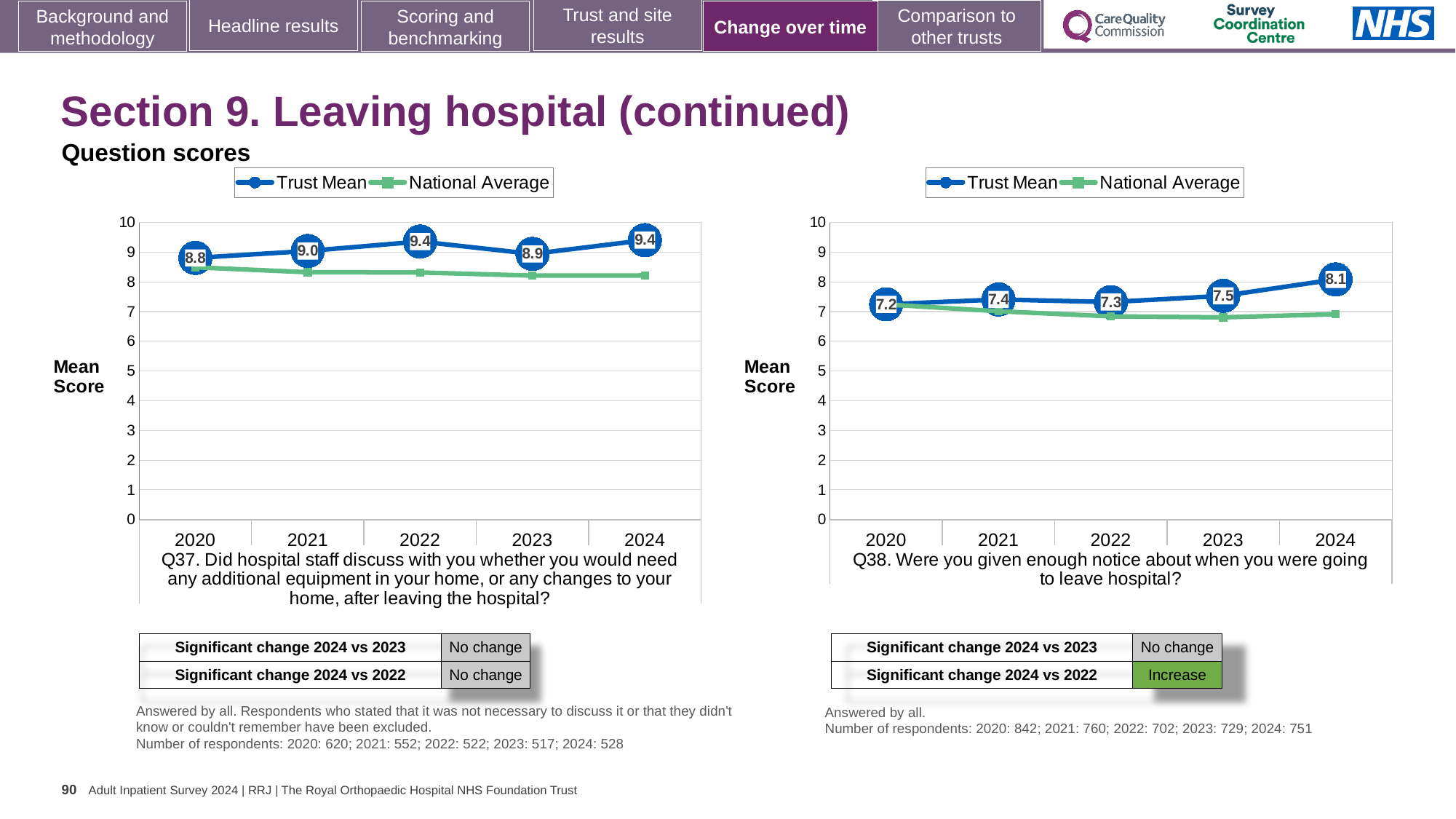
In the Q38 chart, is the National Average for 2022 greater or less than 7? less In the Q38 chart, which year has the highest Trust Mean? 2024 How many series does the legend of the Q37 chart list? 2 In the Q37 chart, what is the Trust Mean for 2022? 9.4 In the Q38 chart, which year has the lowest Trust Mean? 2020 In the Q37 chart, is the Trust Mean for 2021 larger than the Trust Mean for 2023? Yes In the Q38 chart, what is the difference between the Trust Mean for 2024 and the Trust Mean for 2023? 0.6 In the Q37 chart, what is the Trust Mean for 2020? 8.8 In the Q38 chart, what is the Trust Mean for 2024? 8.1 In the Q37 chart, what is the difference between the Trust Mean for 2022 and the Trust Mean for 2023? 0.5 In the Q37 chart, which year has the lowest Trust Mean? 2020 In the Q38 chart, what is the Trust Mean for 2021? 7.4